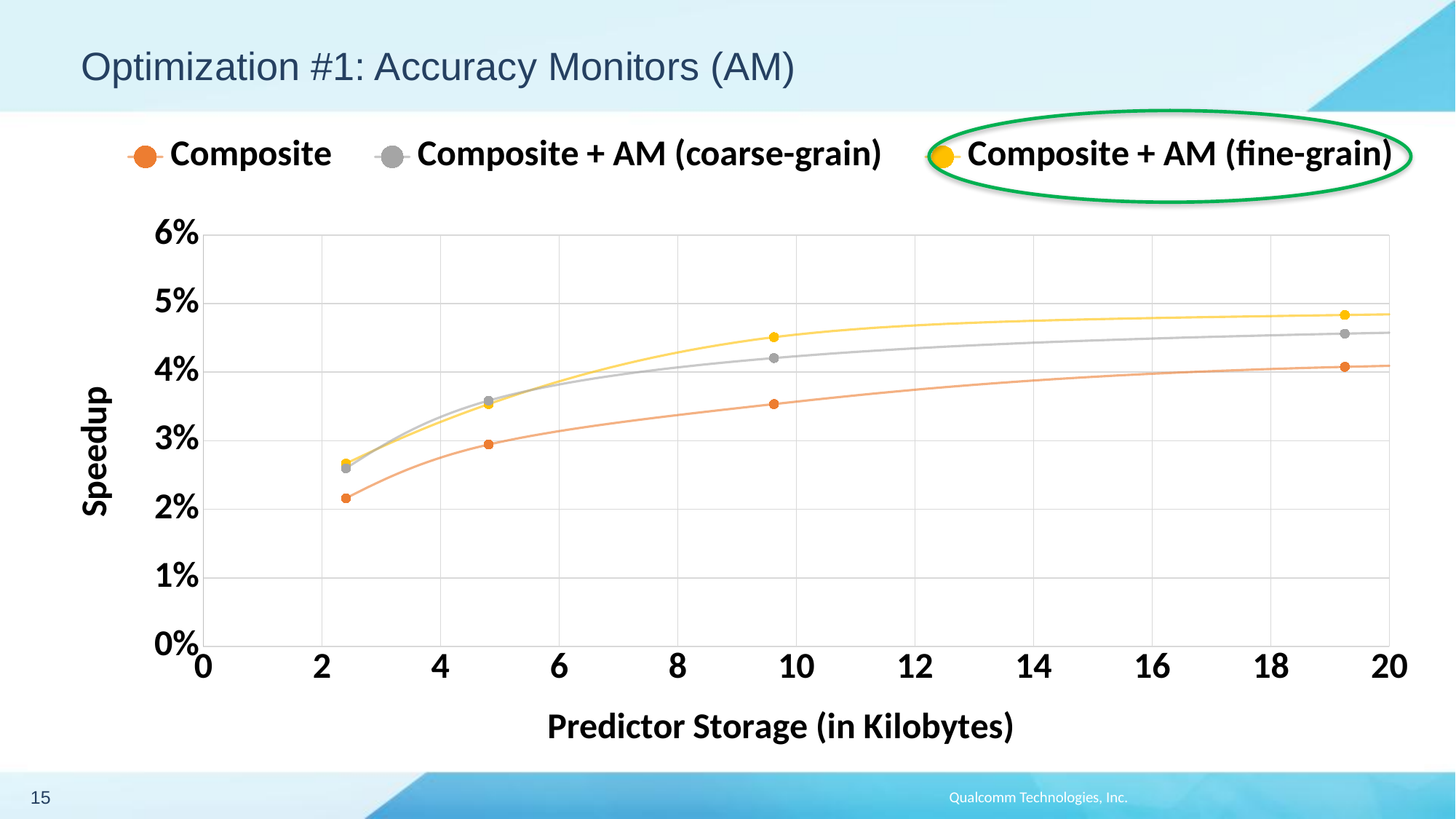
Does the speedup for the Composite series rise or fall as predictor storage increases? rise Is the speedup for Composite at roughly 10 kilobytes greater or less than 4%? less Which series has the highest speedup at the largest predictor storage plotted? Composite + AM (fine-grain) What is the title of the x axis? Predictor Storage (in Kilobytes) Which legend entry is circled in green? Composite + AM (fine-grain) What kind of chart is shown on the slide? line chart At roughly 10 kilobytes of predictor storage, which has the larger speedup: Composite + AM (fine-grain) or Composite + AM (coarse-grain)? Composite + AM (fine-grain) Which series has the lowest speedup at the largest predictor storage plotted? Composite Is the speedup for Composite + AM (fine-grain) at its largest storage point greater or less than 5%? less How many data points are plotted for the Composite series? 4 How many series does the legend list? 3 Is the speedup for Composite + AM (coarse-grain) at roughly 10 kilobytes greater or less than 4%? greater